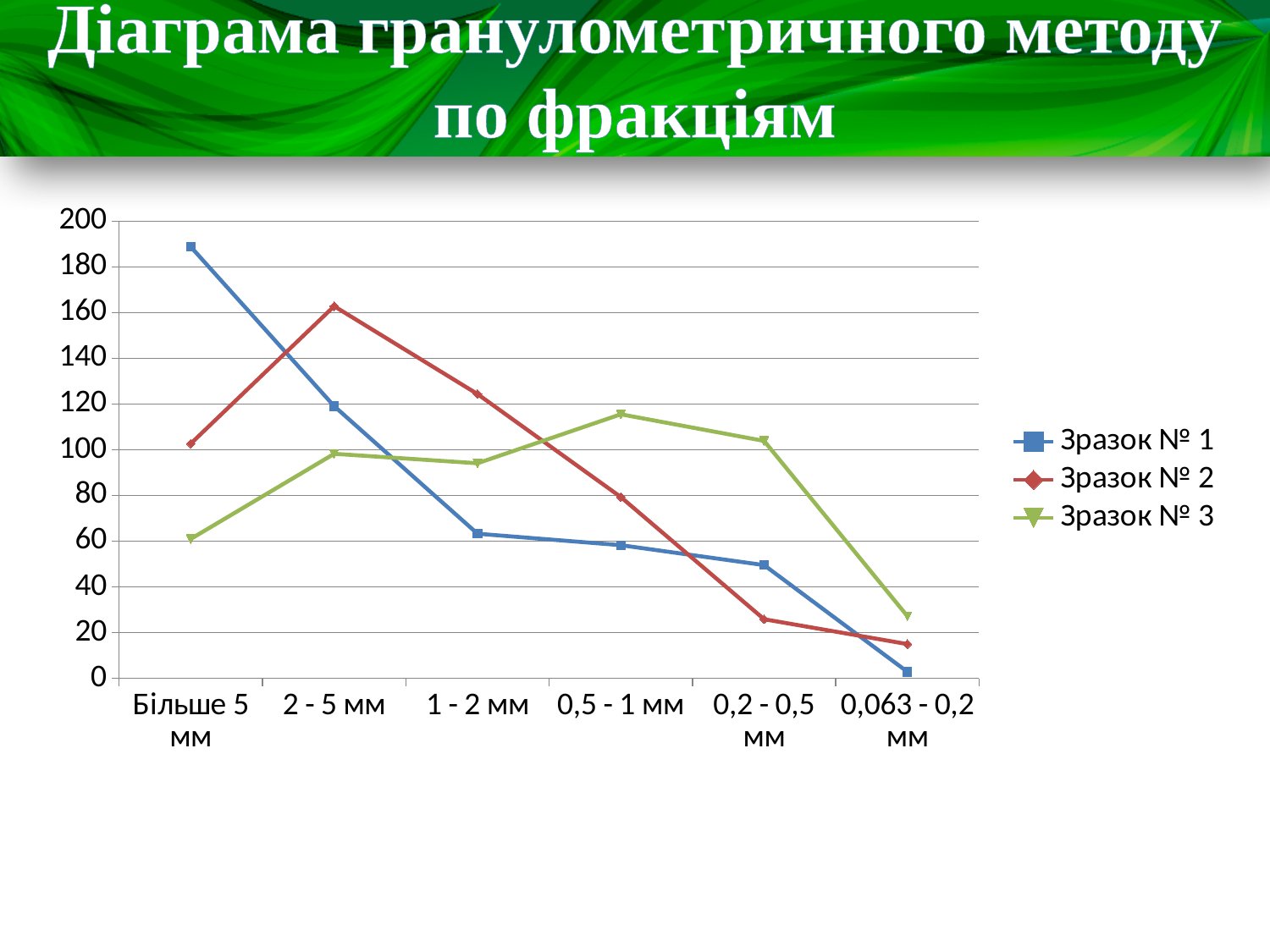
For which category is the value of Зразок № 1 highest? Більше 5 мм How many series does the legend list? 3 Do the values of Зразок № 1 rise or fall from left to right along the x axis? fall For which category is the value of Зразок № 3 highest? 0,5 - 1 мм For which category is the value of Зразок № 2 highest? 2 - 5 мм Is the value for Зразок № 3 at 0,063 - 0,2 мм greater or less than 40? less What kind of chart is shown on the slide? line chart At 1 - 2 мм, which series has the larger value, Зразок № 1 or Зразок № 2? Зразок № 2 Is the value for Зразок № 1 at Більше 5 мм greater or less than 180? greater Is the value for Зразок № 2 at 2 - 5 мм greater or less than 140? greater How many categories are shown on the x axis? 6 For which category is the value of Зразок № 1 lowest? 0,063 - 0,2 мм